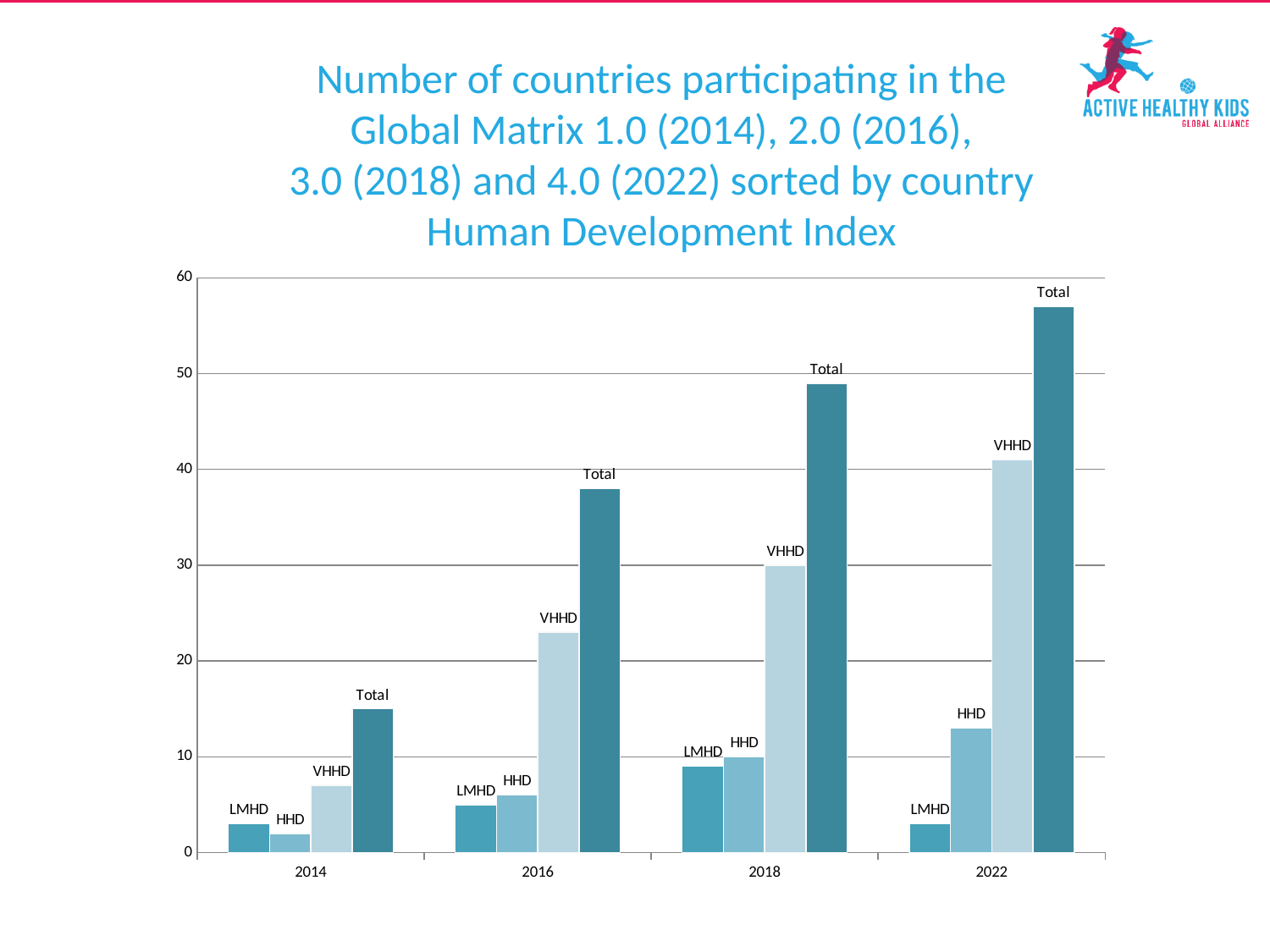
How many years (category groups) are shown along the x axis? 4 How many bars are labelled within each year group (LMHD, HHD, VHHD, Total)? 4 What kind of chart is shown on the slide? Bar chart Is the VHHD value for 2022 greater or less than 40? greater Do the Total bars rise or fall from 2014 to 2022? rise Is the Total value for 2022 greater or less than 50? greater Which is larger, the LMHD bar for 2018 or the LMHD bar for 2022? 2018 What is the VHHD value for 2018? 30 Which years are listed on the x axis of the chart? 2014, 2016, 2018, 2022 Is the Total value for 2016 greater or less than 40? less Which year has the lowest Total bar? 2014 Which year has the highest Total bar? 2022